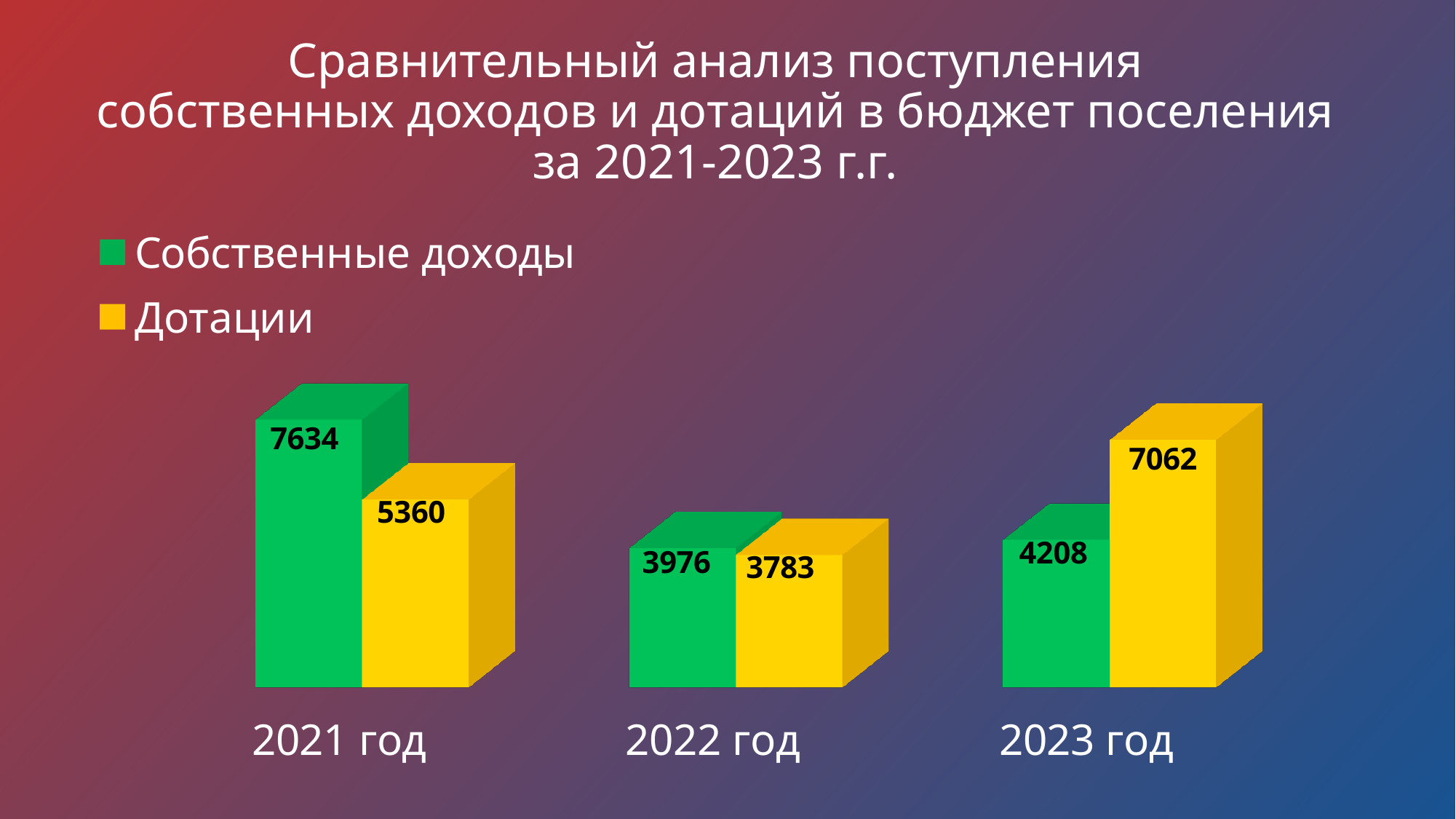
In which year is Дотации lowest? 2022 год What is the value of Собственные доходы for 2021 год? 7634 How many years are shown on the x axis? 3 What is the value of Дотации for 2022 год? 3783 Which is larger in 2023 год, Собственные доходы or Дотации? Дотации What is the value of Собственные доходы for 2023 год? 4208 What kind of chart is shown on the slide? Bar chart What is the difference between Дотации in 2023 год and Дотации in 2022 год? 3279 What is the value of Дотации for 2023 год? 7062 How many series does the legend list? 2 In which year is Собственные доходы highest? 2021 год What is the difference between Собственные доходы and Дотации in 2021 год? 2274